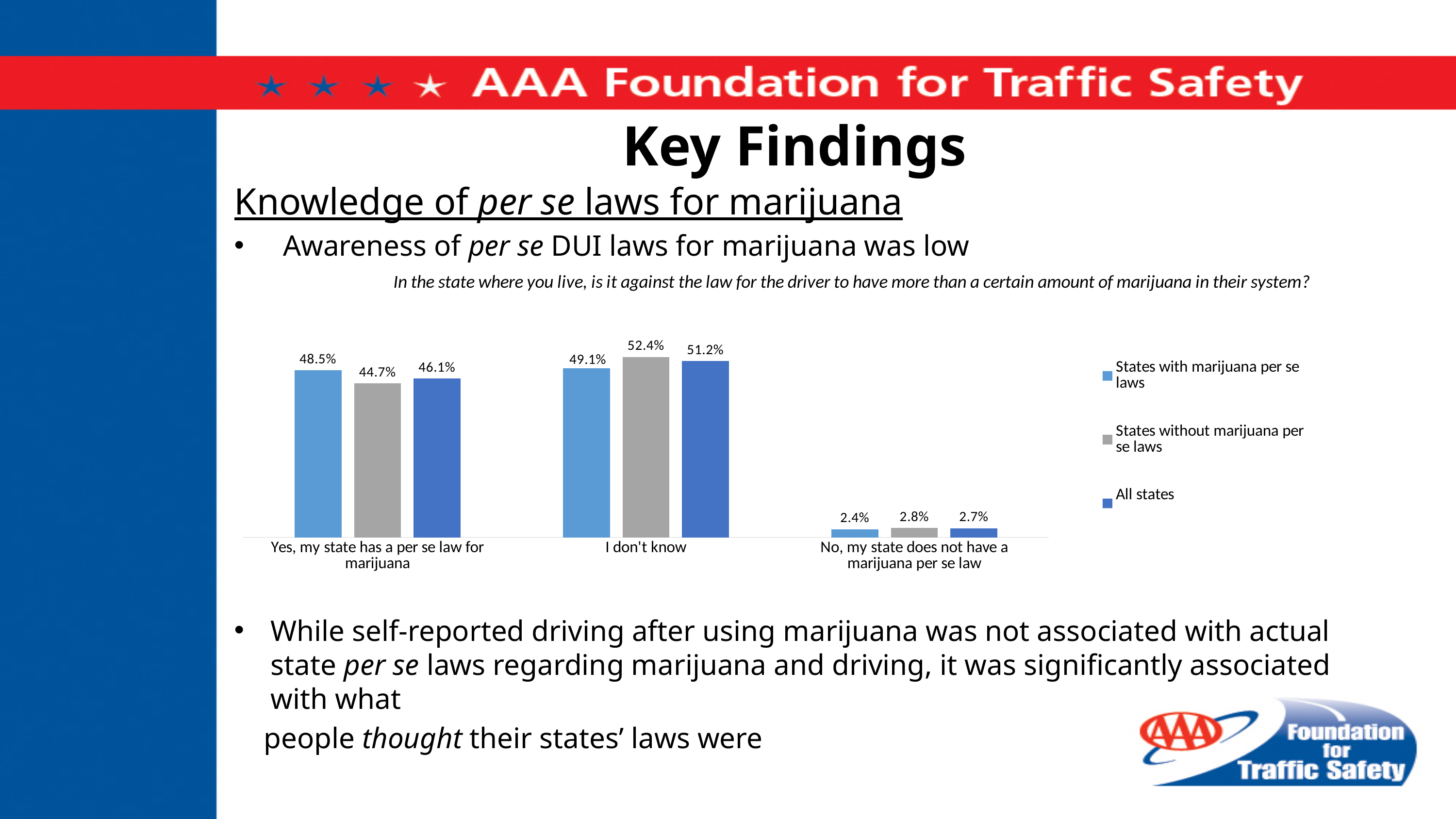
What percentage of respondents in states with marijuana per se laws answered "Yes, my state has a per se law for marijuana"? 48.5% Which series has the highest value in the "I don't know" category? States without marijuana per se laws Which legend entry is shown in gray? States without marijuana per se laws What kind of chart is shown on the slide? Bar chart In the "I don't know" category, which is larger: the value for "States with marijuana per se laws" or "States without marijuana per se laws"? States without marijuana per se laws What is the difference between the "States with marijuana per se laws" and "States without marijuana per se laws" values in the "Yes, my state has a per se law for marijuana" category? 3.8% What is the value for "States without marijuana per se laws" in the "No, my state does not have a marijuana per se law" category? 2.8% Which response category has the lowest values across all three series? No, my state does not have a marijuana per se law What is the difference between the "All states" values for "I don't know" and "Yes, my state has a per se law for marijuana"? 5.1% How many response categories are shown on the x axis of the chart? 3 How many series does the chart's legend list? 3 What is the value for "All states" in the "I don't know" category? 51.2%